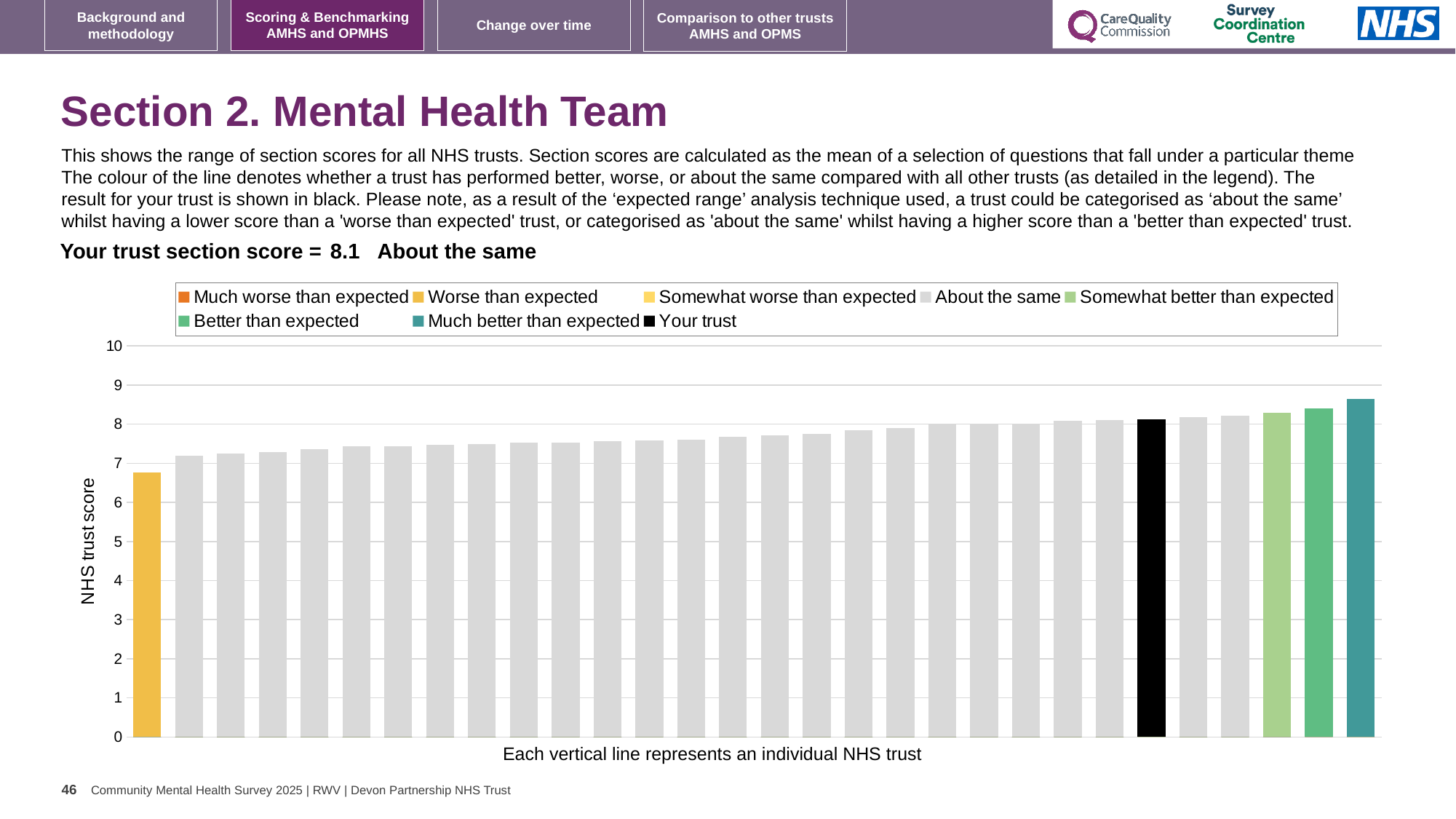
Is the value of the leftmost (yellow) bar greater or less than 7? less Is the value of the rightmost (teal) bar greater or less than 8? greater Is the value of the rightmost (teal) bar greater or less than 9? less Which legend category does the shortest bar belong to? Worse than expected What is the label on the vertical axis of the chart? NHS trust score Which performance category is your trust placed in for this section? About the same What kind of chart is shown on the slide? bar chart What is the section score for your trust shown on the slide? 8.1 Which is taller: the black 'Your trust' bar or the yellow 'Worse than expected' bar? the black 'Your trust' bar Do the bar values rise or fall from left to right along the x axis? rise How many entries does the chart legend list? 8 Which legend category does the tallest bar belong to? Much better than expected